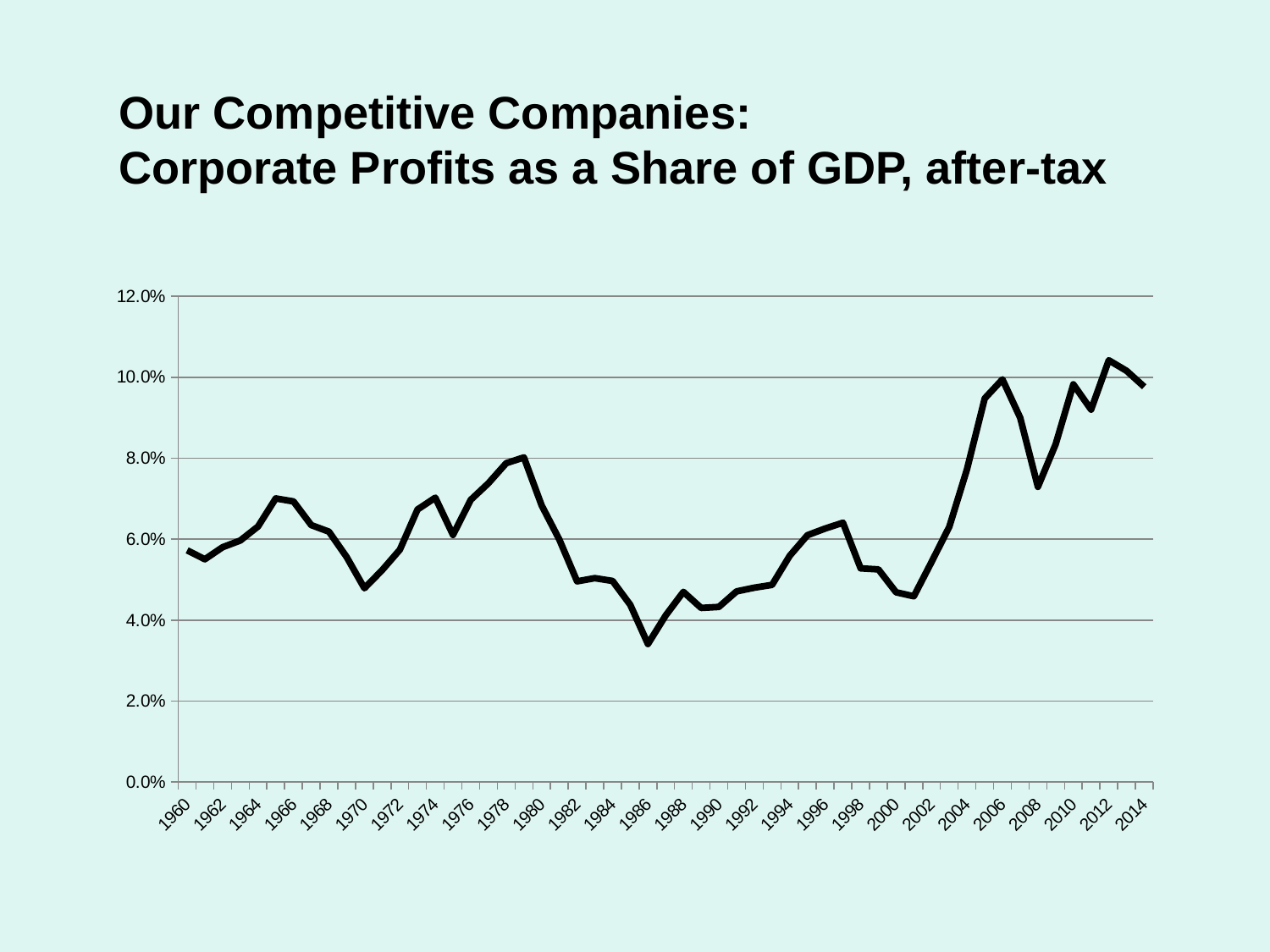
Which year has the larger value, 1970 or 1986? 1970 In which year does the line reach its lowest value? 1986 In which year does the line reach its highest value? 2012 Is the value for 2006 greater or less than 8.0%? greater Is the value for 1970 greater or less than 6.0%? less Which year has the larger value, 2012 or 1979? 2012 Is the value for 2008 greater or less than 8.0%? less What kind of chart is shown on the slide? line chart Does the line rise or fall between 2001 and 2006? rise What is the highest value shown on the vertical axis? 12.0%